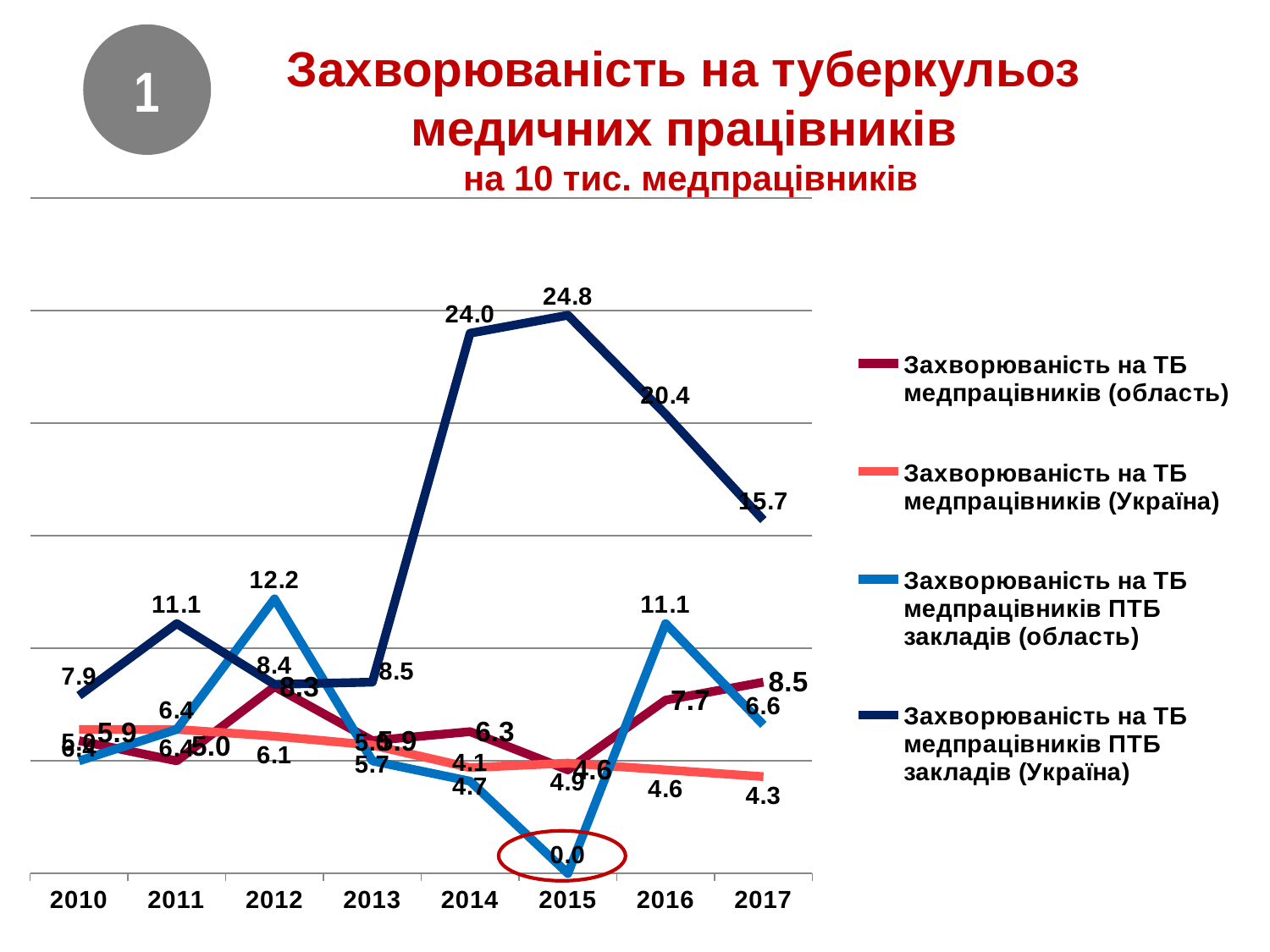
What is the difference between the 2015 and 2016 values for 'Захворюваність на ТБ медпрацівників ПТБ закладів (Україна)'? 4.4 What is the value for 'Захворюваність на ТБ медпрацівників ПТБ закладів (Україна)' in 2014? 24.0 In which year is the value for 'Захворюваність на ТБ медпрацівників ПТБ закладів (область)' lowest? 2015 How many years are shown on the x axis? 8 Does the series 'Захворюваність на ТБ медпрацівників ПТБ закладів (Україна)' rise or fall from 2015 to 2017? fall What kind of chart is shown on the slide? line chart How many series does the legend list? 4 In 2016, which is larger: 'Захворюваність на ТБ медпрацівників ПТБ закладів (область)' or 'Захворюваність на ТБ медпрацівників ПТБ закладів (Україна)'? Захворюваність на ТБ медпрацівників ПТБ закладів (Україна) In which year does the series 'Захворюваність на ТБ медпрацівників ПТБ закладів (Україна)' reach its highest value? 2015 What is the value for 'Захворюваність на ТБ медпрацівників (Україна)' in 2017? 4.3 What is the value for 'Захворюваність на ТБ медпрацівників ПТБ закладів (Україна)' in 2017? 15.7 What is the value for 'Захворюваність на ТБ медпрацівників ПТБ закладів (область)' in 2012? 12.2